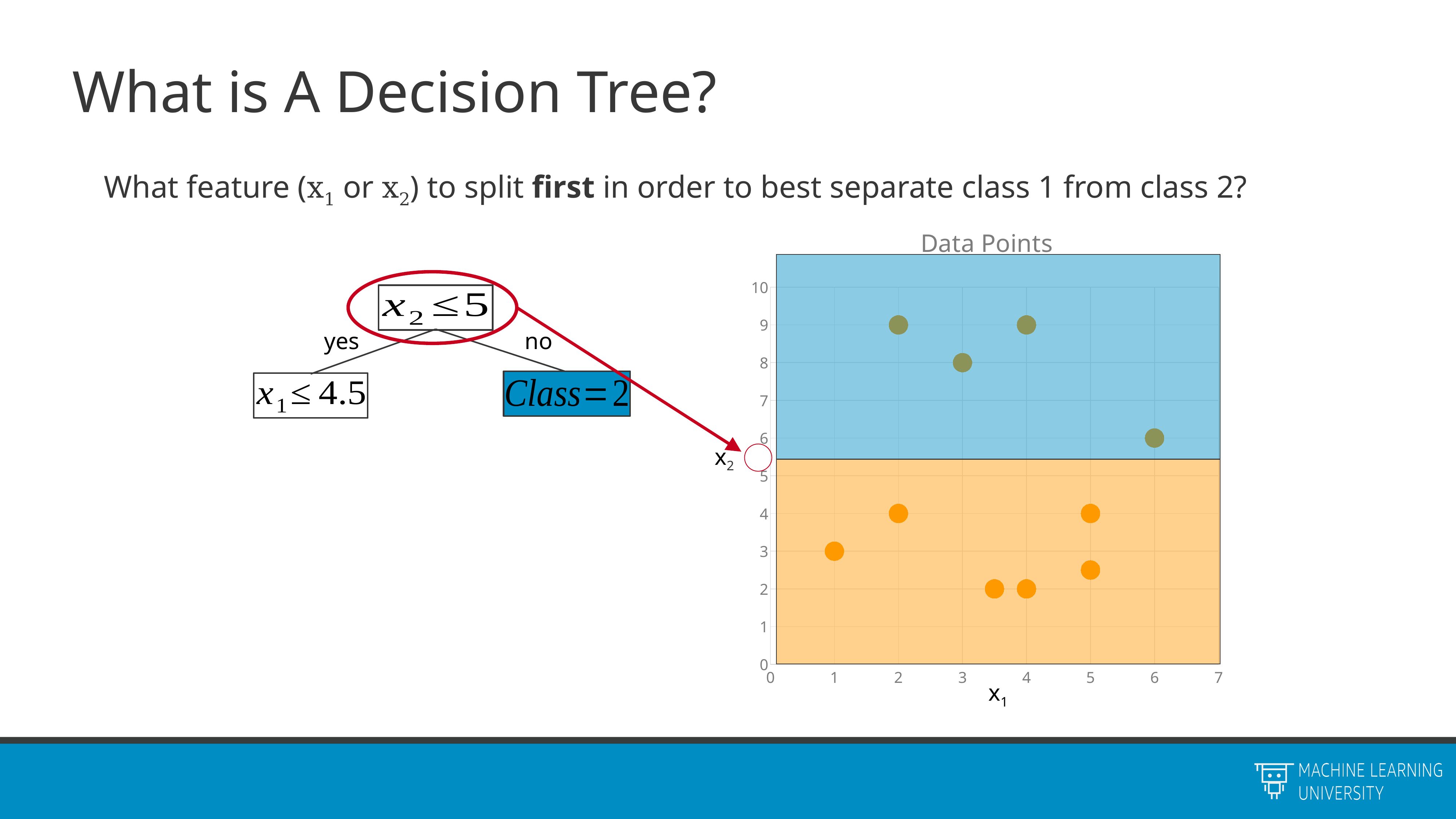
What is the title of the chart on the slide? Data Points In the "Data Points" chart, what is the x2 value of the green point at x1 = 6? 6 How many orange data points are plotted in the "Data Points" chart? 6 How many data points are plotted in the "Data Points" chart? 10 In the "Data Points" chart, what is the x2 value of the orange point at x1 = 1? 3 In the "Data Points" chart, is the x2 value of the green point at x1 = 6 greater or less than 5? greater In the "Data Points" chart, what is the highest x2 value reached by any point? 9 In the "Data Points" chart, which has the larger x2 value: the green point at x1 = 3 or the orange point at x1 = 1? the green point at x1 = 3 How many green data points are plotted in the "Data Points" chart? 4 What label is shown on the horizontal axis of the "Data Points" chart? x1 What kind of chart is the "Data Points" chart? scatter chart In the "Data Points" chart, what is the x1 value of the green point at x2 = 8? 3